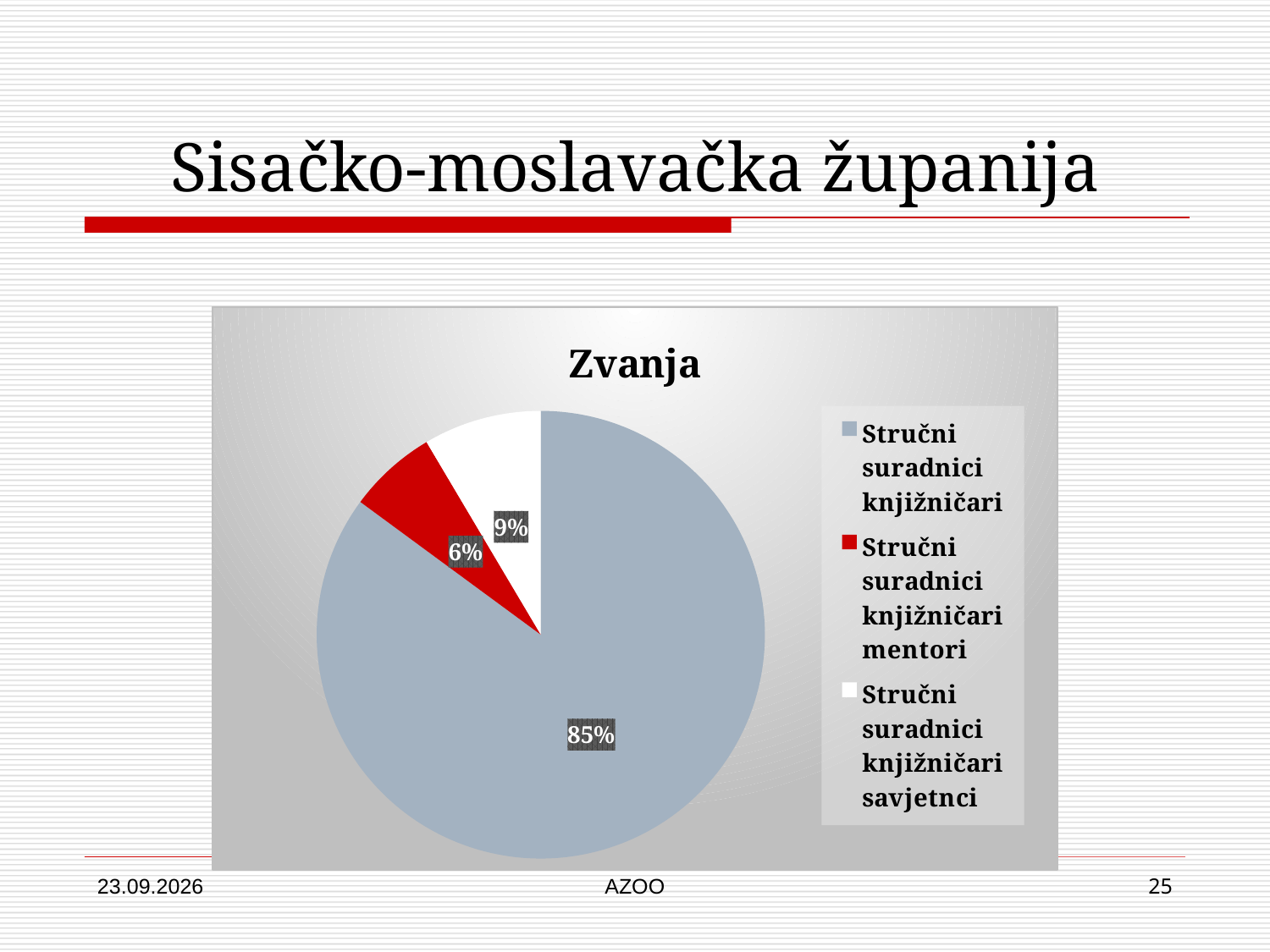
How many slices does the pie chart have? 3 Which is larger: the share for Stručni suradnici knjižničari mentori or for Stručni suradnici knjižničari savjetnici? Stručni suradnici knjižničari savjetnici How many entries does the legend list? 3 Which category has the largest slice of the pie? Stručni suradnici knjižničari What share of the pie is Stručni suradnici knjižničari mentori? 6% What colour is the slice for Stručni suradnici knjižničari mentori? red What share of the pie is Stručni suradnici knjižničari savjetnici? 9% What kind of chart is shown on the slide? pie chart What is the difference in percentage points between Stručni suradnici knjižničari and Stručni suradnici knjižničari savjetnici? 76 Which category has the smallest slice of the pie? Stručni suradnici knjižničari mentori What is the title of the chart? Zvanja What share of the pie is Stručni suradnici knjižničari? 85%